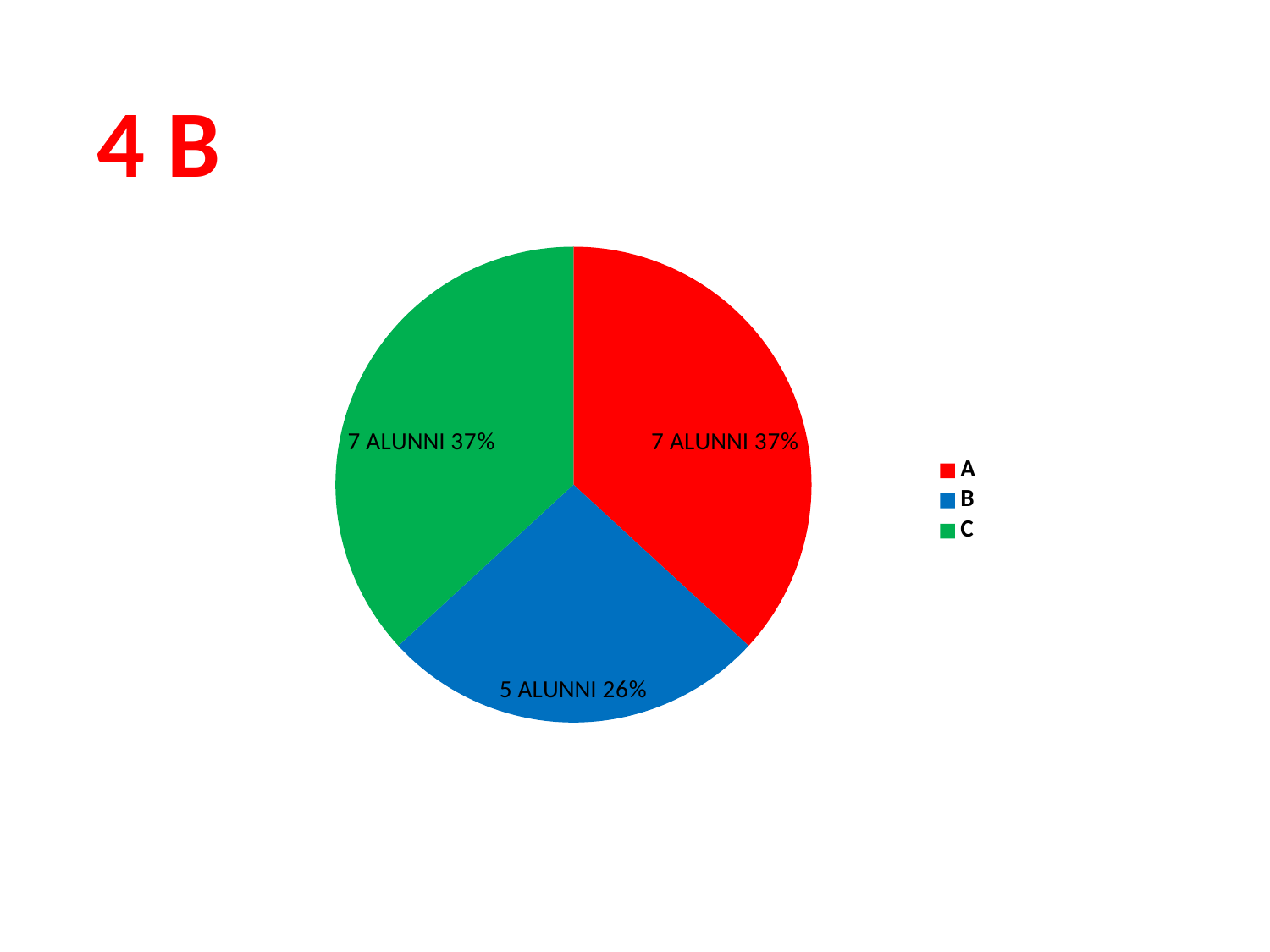
What share of the pie does slice A represent? 37% How many alunni are in category A? 7 How many alunni are in category B? 5 What kind of chart is shown on the slide? pie chart What is the difference in number of alunni between category C and category B? 2 What colour is the slice for category C? green Which is larger, the slice for A or the slice for B? A Which category has the smallest slice? B How many slices does the pie chart have? 3 How many entries does the legend list? 3 What share of the pie does slice B represent? 26% What share of the pie does slice C represent? 37%